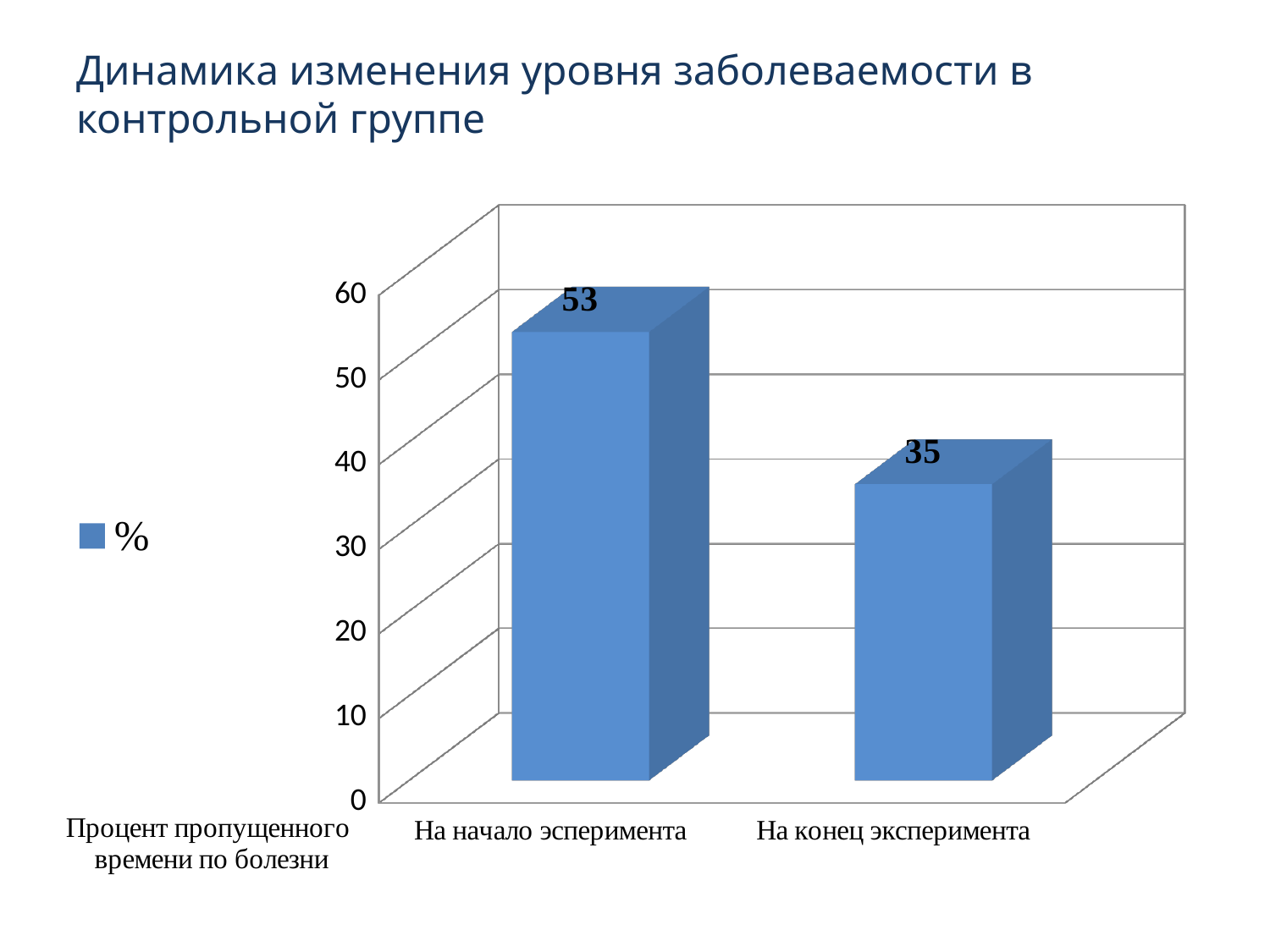
What is the value for "На начало эсперимента"? 53 Is the value for "На конец эксперимента" greater or less than 40? less Which category has the highest value? На начало эсперимента Is the value for "На начало эсперимента" greater or less than 50? greater What is the difference between the values for "На начало эсперимента" and "На конец эксперимента"? 18 How many series does the legend list? 1 How many categories are shown on the chart? 2 Which is larger: the value for "На начало эсперимента" or for "На конец эксперимента"? На начало эсперимента Do the values rise or fall from the start to the end of the experiment? Fall Which category has the lowest value? На конец эксперимента What is the value for "На конец эксперимента"? 35 What kind of chart is shown on the slide? Bar chart